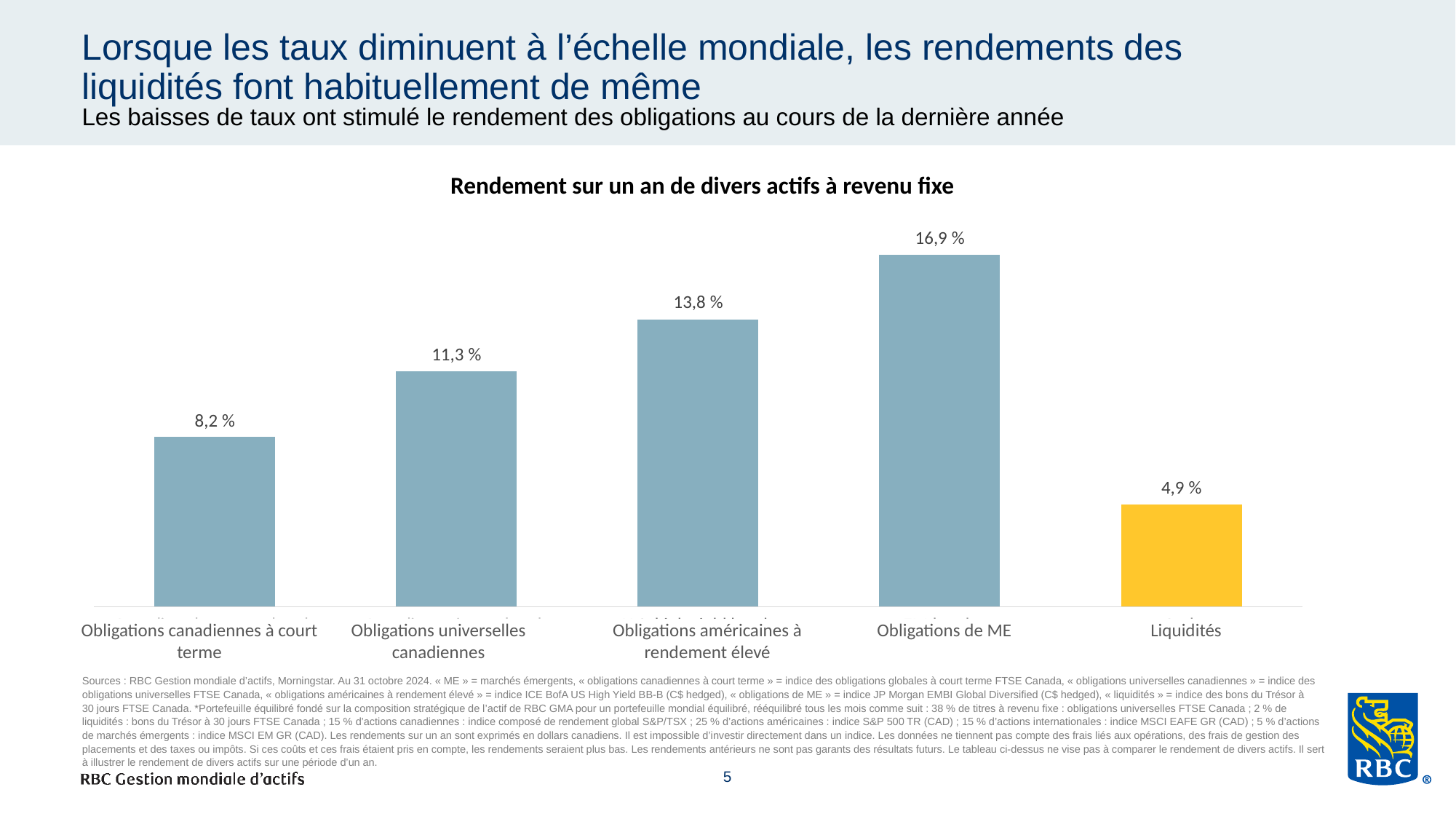
What is the value shown for Obligations canadiennes à court terme? 8,2 % How many categories are shown in the chart? 5 What is the value shown for Obligations universelles canadiennes? 11,3 % Which category has the lowest one-year return? Liquidités What kind of chart is shown on the slide? Bar chart What is the one-year return for Liquidités? 4,9 % Which bar is coloured yellow rather than blue-grey? Liquidités What is the difference between the returns of Obligations de ME and Liquidités? 12,0 % Which category has the highest one-year return? Obligations de ME Which is larger: the return for Obligations américaines à rendement élevé or for Obligations canadiennes à court terme? Obligations américaines à rendement élevé What is the difference between Obligations américaines à rendement élevé and Obligations universelles canadiennes? 2,5 % What is the one-year return for Obligations de ME? 16,9 %